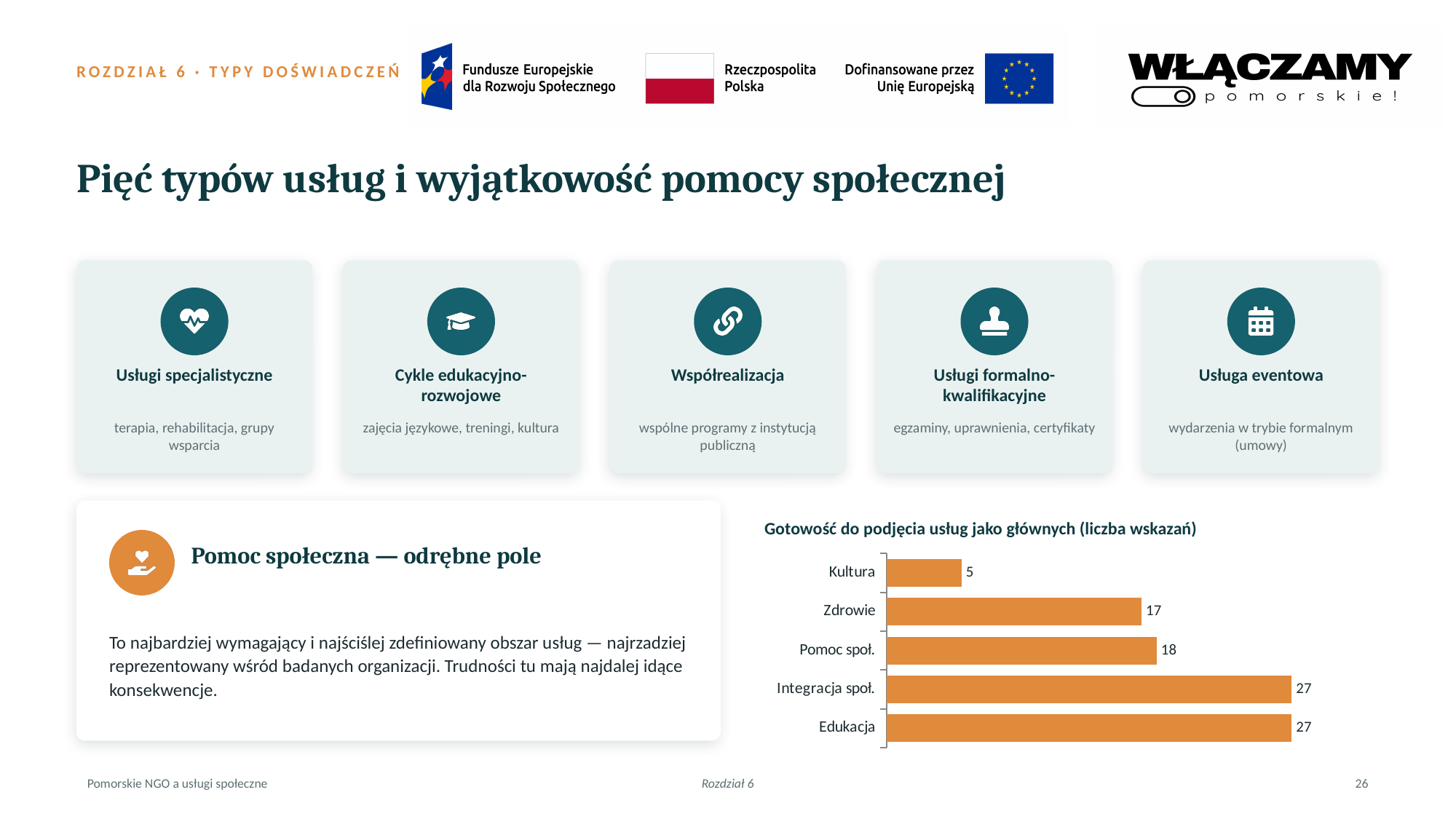
Which category has the lowest value in the chart? Kultura What is the difference between the values for Zdrowie and Kultura? 12 What is the highest value shown in the chart? 27 What is the difference between the values for Integracja społ. and Pomoc społ.? 9 What is the title of the chart? Gotowość do podjęcia usług jako głównych (liczba wskazań) What is the value for Edukacja in the chart? 27 What is the value for Pomoc społ. in the chart? 18 What is the value for Zdrowie in the chart? 17 How many categories are shown in the chart? 5 What is the value for Kultura in the chart? 5 Which is larger, the value for Edukacja or the value for Zdrowie? Edukacja What kind of chart is shown on the slide? Bar chart